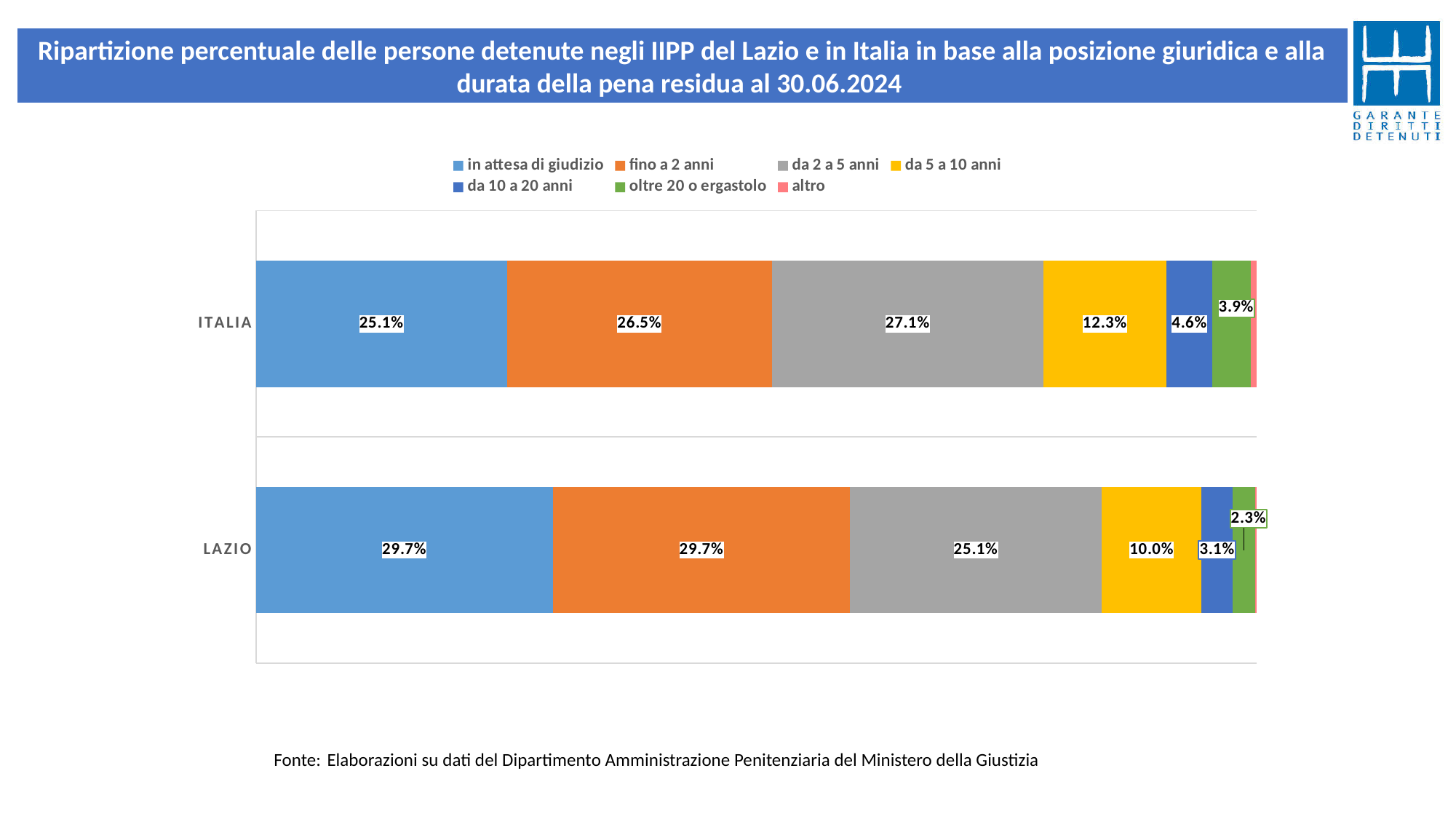
What is the value for 'fino a 2 anni' for LAZIO? 29.7% What is the value for 'da 5 a 10 anni' for LAZIO? 10.0% What is the value for 'da 10 a 20 anni' for LAZIO? 3.1% What is the difference between the 'da 5 a 10 anni' values for ITALIA and LAZIO? 2.3% What kind of chart is shown on the slide? Stacked bar chart Which is larger: 'in attesa di giudizio' for ITALIA or for LAZIO? LAZIO How many categories (bars) are shown on the chart? 2 What is the value for 'in attesa di giudizio' for ITALIA? 25.1% What is the value for 'da 2 a 5 anni' for ITALIA? 27.1% Which series has the largest value in the ITALIA bar? da 2 a 5 anni How many series does the legend list? 7 What is the value for 'oltre 20 o ergastolo' for ITALIA? 3.9%